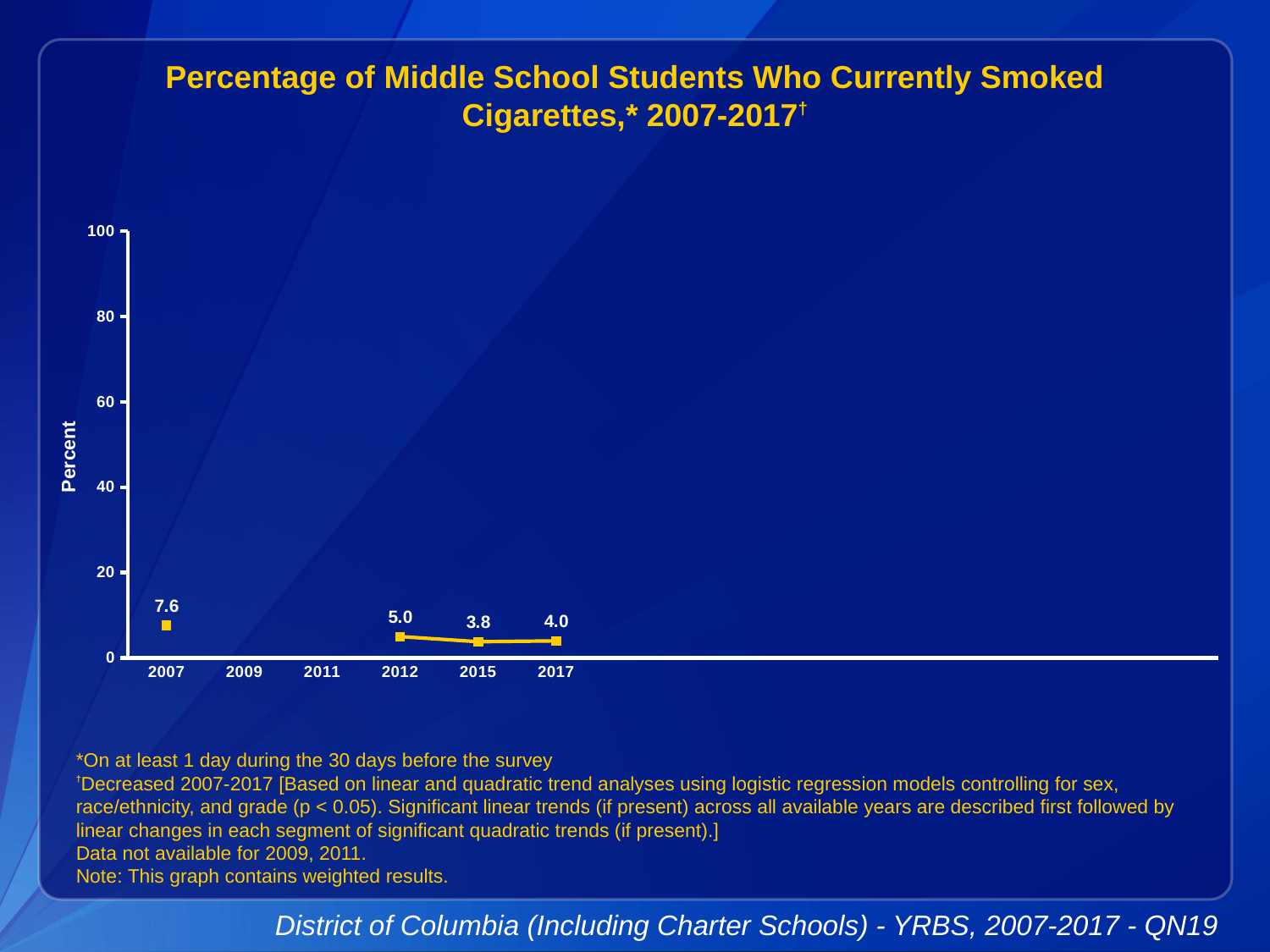
What is the label on the y axis? Percent Which is larger, the value for 2012 or the value for 2015? 2012 What kind of chart is shown on the slide? line chart Which year has the lowest percentage of students who currently smoked cigarettes? 2015 What is the value plotted for 2015? 3.8 What percentage of middle school students currently smoked cigarettes in 2007? 7.6 What is the difference between the 2007 value and the 2017 value? 3.6 Is the value for 2007 greater or less than 20? less How many years have data points plotted on the chart? 4 What is the value plotted for 2017? 4.0 What is the value plotted for 2012? 5.0 Which year has the highest percentage of students who currently smoked cigarettes? 2007